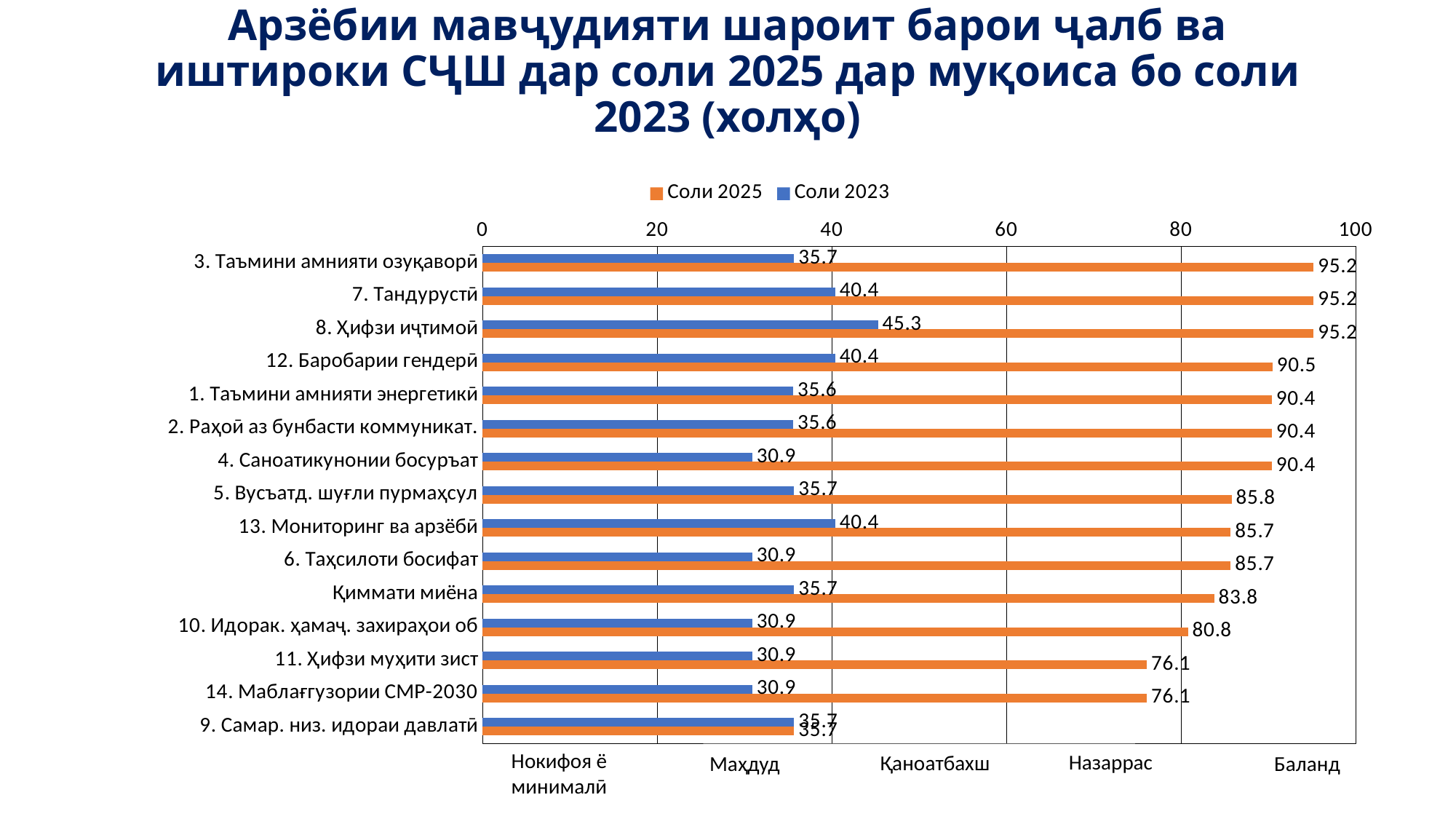
How many categories are shown on the chart? 15 What kind of chart is shown on the slide? Bar chart What is the difference between the Соли 2025 and Соли 2023 values for 3. Таъмини амнияти озуқаворӣ? 59.5 What is the Соли 2025 value for Қиммати миёна? 83.8 Which category has the highest Соли 2023 value? 8. Ҳифзи иҷтимоӣ Which category has the lowest Соли 2025 value? 9. Самар. низ. идораи давлатӣ How many series does the legend list? 2 Is the Соли 2025 value for 14. Маблағгузории СМР-2030 greater or less than 80? less What is the Соли 2023 value for 8. Ҳифзи иҷтимоӣ? 45.3 What is the Соли 2023 value for 4. Саноатикунонии босуръат? 30.9 Which is larger: the Соли 2025 value for 10. Идорак. ҳамаҷ. захираҳои об or for 11. Ҳифзи муҳити зист? 10. Идорак. ҳамаҷ. захираҳои об What is the Соли 2025 value for 7. Тандурустӣ? 95.2